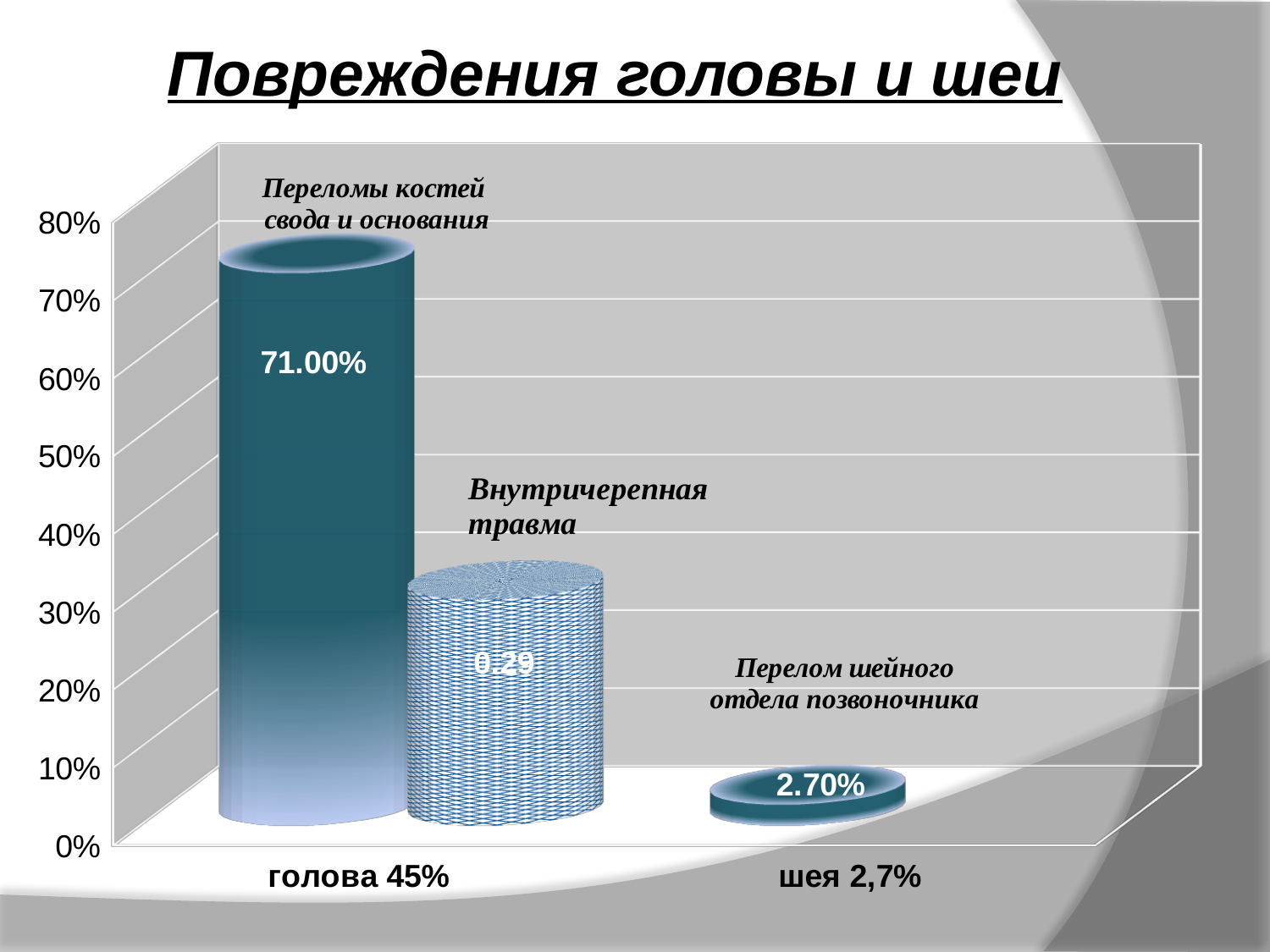
What is the value shown for Переломы костей свода и основания? 71.00% Is the bar for Внутричерепная травма greater or less than 40%? less What kind of chart is shown on the slide? bar chart Is the bar for Переломы костей свода и основания greater or less than 60%? greater Which is larger: the bar for Переломы костей свода и основания or the bar for Внутричерепная травма? Переломы костей свода и основания Which injury type has the highest bar on the chart? Переломы костей свода и основания What is the title of the slide? Повреждения головы и шеи Which injury type has the lowest bar on the chart? Перелом шейного отдела позвоночника What is the value shown for Перелом шейного отдела позвоночника? 2.70% Is the bar for Перелом шейного отдела позвоночника greater or less than 10%? less How many bars are plotted on the chart? 3 What is the data label shown on the Внутричерепная травма bar? 0.29